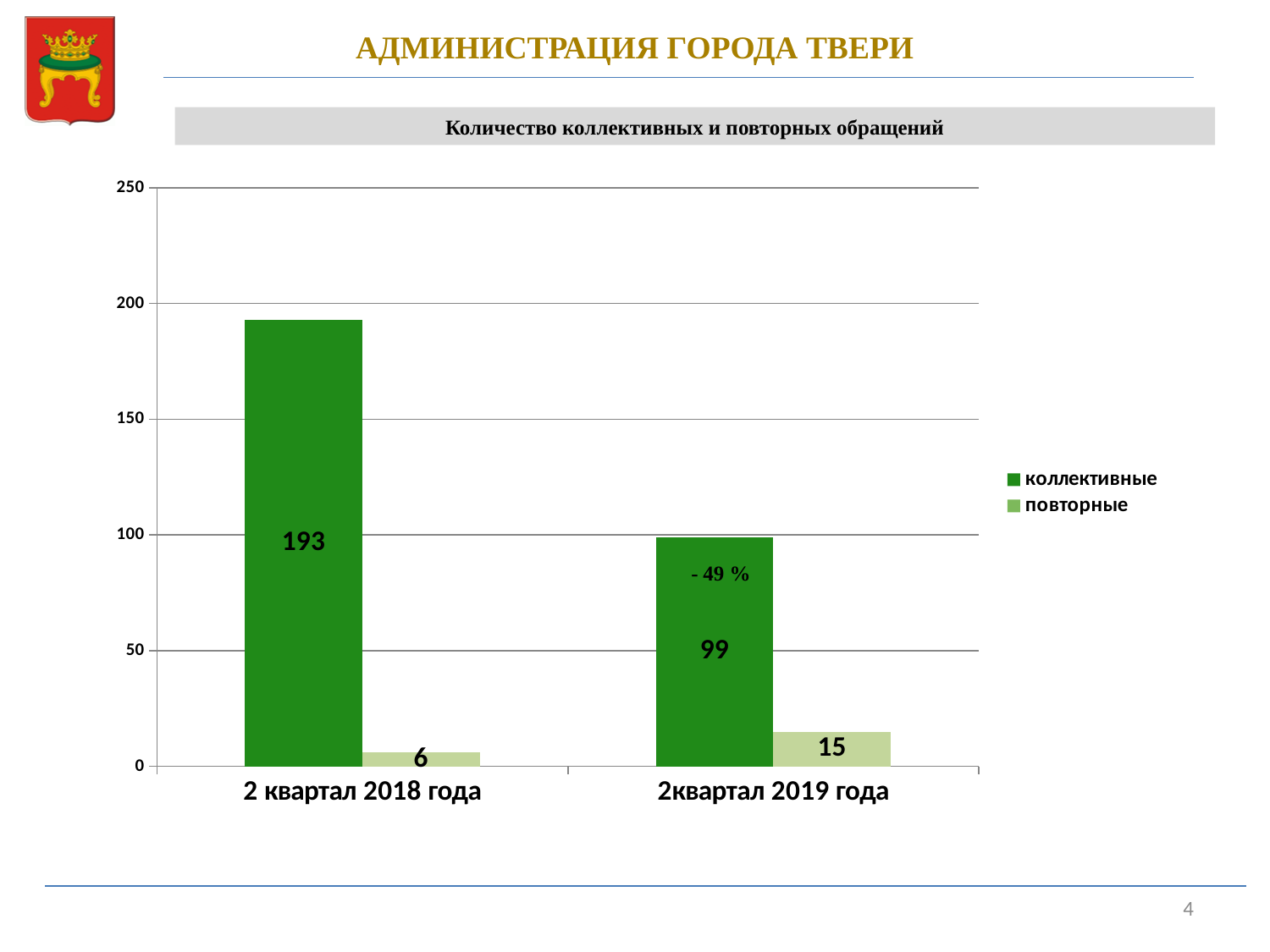
What kind of chart is shown on the slide? bar chart What is the difference between the повторные values for 2квартал 2019 года and 2 квартал 2018 года? 9 What is the value for повторные in 2 квартал 2018 года? 6 What is the value for коллективные in 2квартал 2019 года? 99 Is the value for коллективные in 2квартал 2019 года greater or less than 100? less What is the value for коллективные in 2 квартал 2018 года? 193 What is the difference between the коллективные values for 2 квартал 2018 года and 2квартал 2019 года? 94 Which period has the lower value for повторные? 2 квартал 2018 года What percentage change is annotated on the коллективные bar for 2квартал 2019 года? - 49 % How many series does the legend list? 2 Which period has the higher value for коллективные? 2 квартал 2018 года What is the value for повторные in 2квартал 2019 года? 15